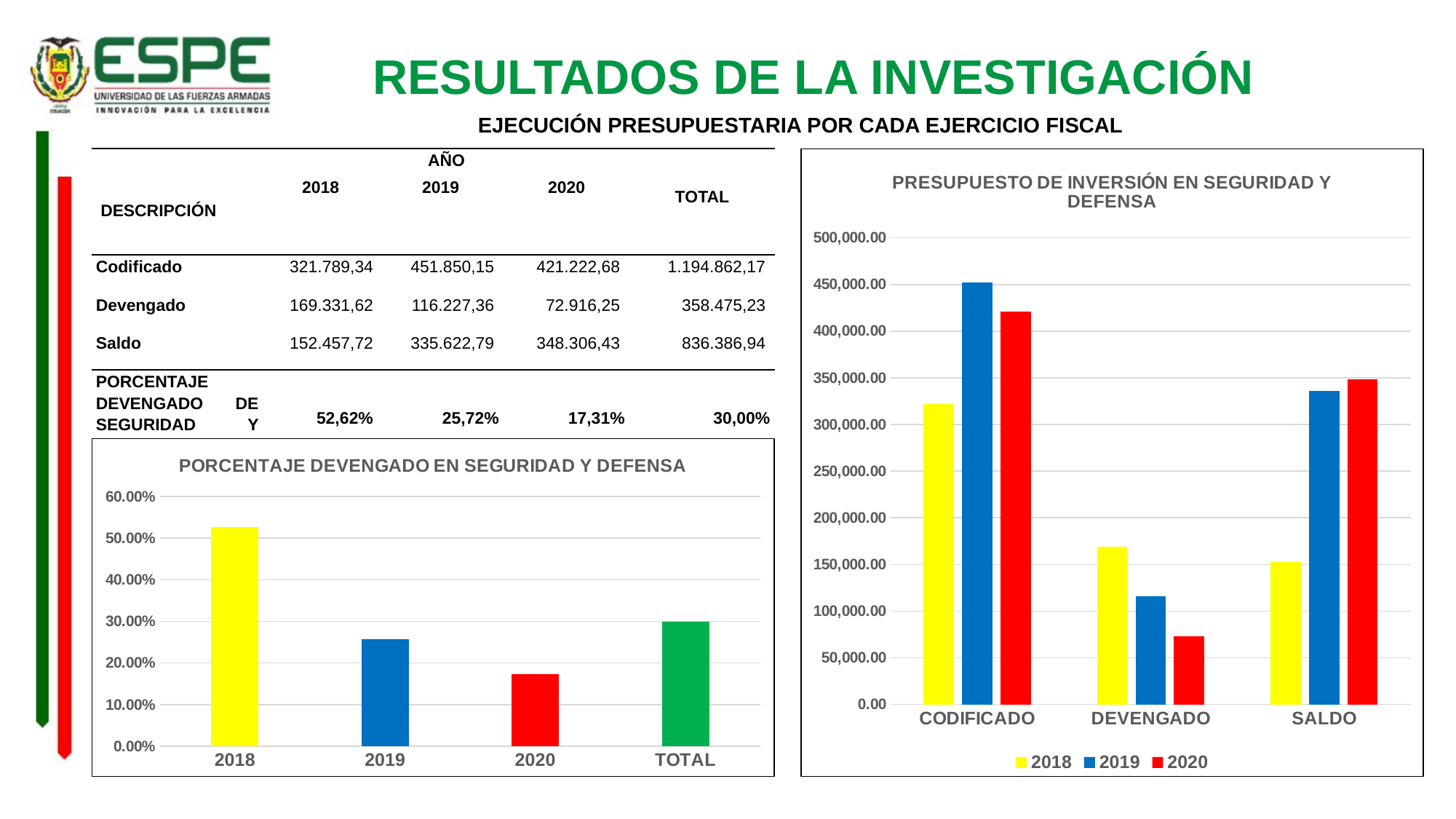
In the chart 'PORCENTAJE DEVENGADO EN SEGURIDAD Y DEFENSA', how many bars are plotted? 4 In the chart 'PRESUPUESTO DE INVERSIÓN EN SEGURIDAD Y DEFENSA', for SALDO, which is larger: the 2018 bar or the 2020 bar? 2020 In the chart 'PRESUPUESTO DE INVERSIÓN EN SEGURIDAD Y DEFENSA', is the 2020 value for DEVENGADO greater or less than 100,000.00? less In the chart 'PORCENTAJE DEVENGADO EN SEGURIDAD Y DEFENSA', which category has the highest value? 2018 In the chart 'PORCENTAJE DEVENGADO EN SEGURIDAD Y DEFENSA', which category has the lowest value? 2020 How many series does the legend of the chart 'PRESUPUESTO DE INVERSIÓN EN SEGURIDAD Y DEFENSA' list? 3 In the chart 'PORCENTAJE DEVENGADO EN SEGURIDAD Y DEFENSA', is the value for TOTAL greater or less than 20.00%? greater In the chart 'PRESUPUESTO DE INVERSIÓN EN SEGURIDAD Y DEFENSA', which year has the highest bar for CODIFICADO? 2019 How many categories are shown on the x axis of the chart 'PRESUPUESTO DE INVERSIÓN EN SEGURIDAD Y DEFENSA'? 3 What kind of chart is the chart titled 'PORCENTAJE DEVENGADO EN SEGURIDAD Y DEFENSA'? bar chart In the chart 'PORCENTAJE DEVENGADO EN SEGURIDAD Y DEFENSA', is the value for 2019 greater or less than 30.00%? less In the chart 'PRESUPUESTO DE INVERSIÓN EN SEGURIDAD Y DEFENSA', do the DEVENGADO bars rise or fall from 2018 to 2020? fall